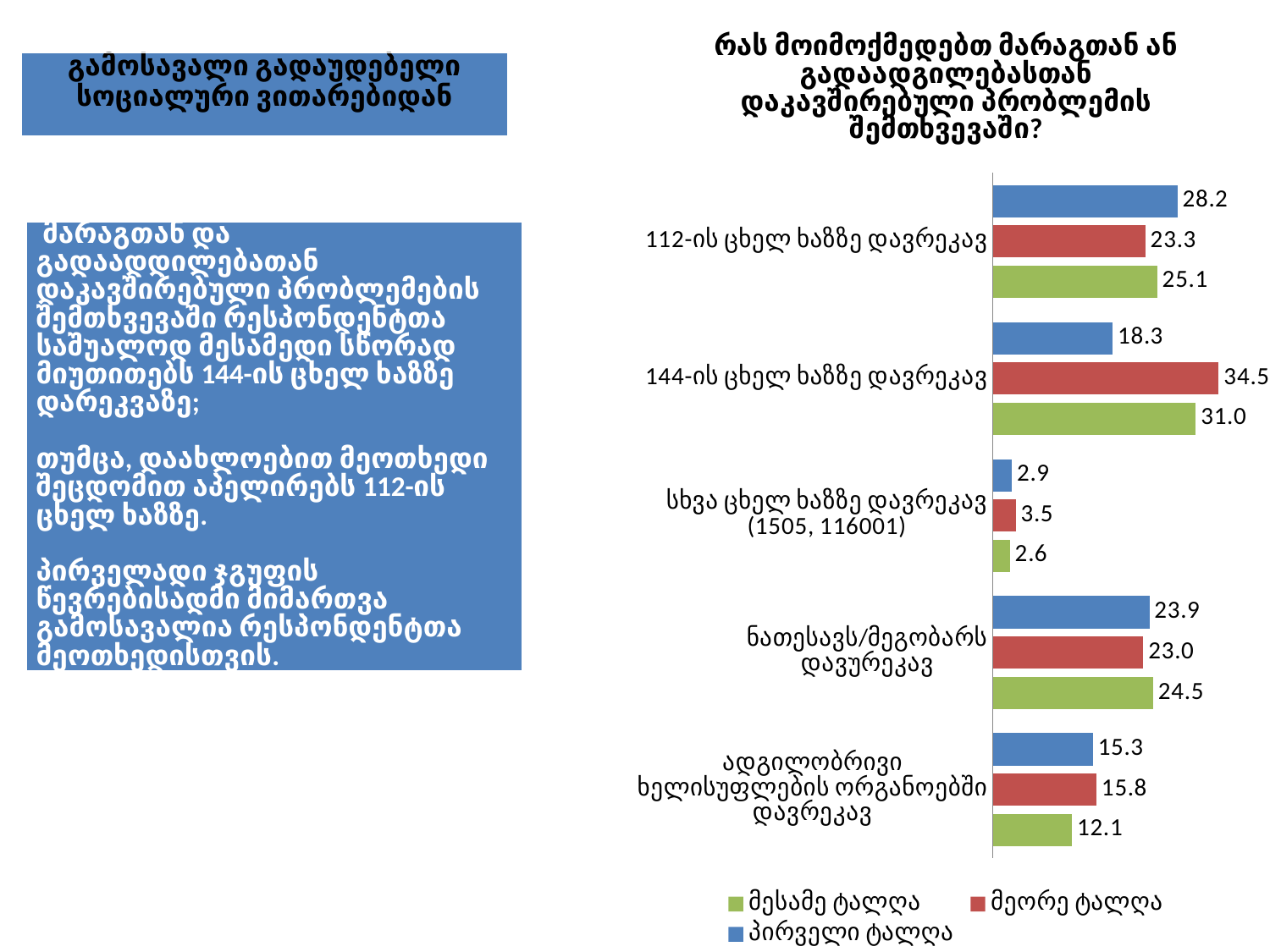
What is the value for პირველი ტალღა in the category 112-ის ცხელ ხაზზე დავრეკავ? 28.2 Which category has the lowest value for მეორე ტალღა? სხვა ცხელ ხაზზე დავრეკავ (1505, 116001) What is the value for მესამე ტალღა in the category ნათესავს/მეგობარს დავურეკავ? 24.5 What type of chart is shown on the slide? bar chart How many series does the chart legend list? 3 For 112-ის ცხელ ხაზზე დავრეკავ, which is larger: the value for პირველი ტალღა or for მეორე ტალღა? პირველი ტალღა What is the value for მეორე ტალღა in the category 144-ის ცხელ ხაზზე დავრეკავ? 34.5 How many categories are shown on the chart? 5 What is the value for მესამე ტალღა in the category ადგილობრივი ხელისუფლების ორგანოებში დავრეკავ? 12.1 What is the difference between the მეორე ტალღა and პირველი ტალღა values for 144-ის ცხელ ხაზზე დავრეკავ? 16.2 Which category has the highest value for მესამე ტალღა? 144-ის ცხელ ხაზზე დავრეკავ Which legend entry is shown in green? მესამე ტალღა